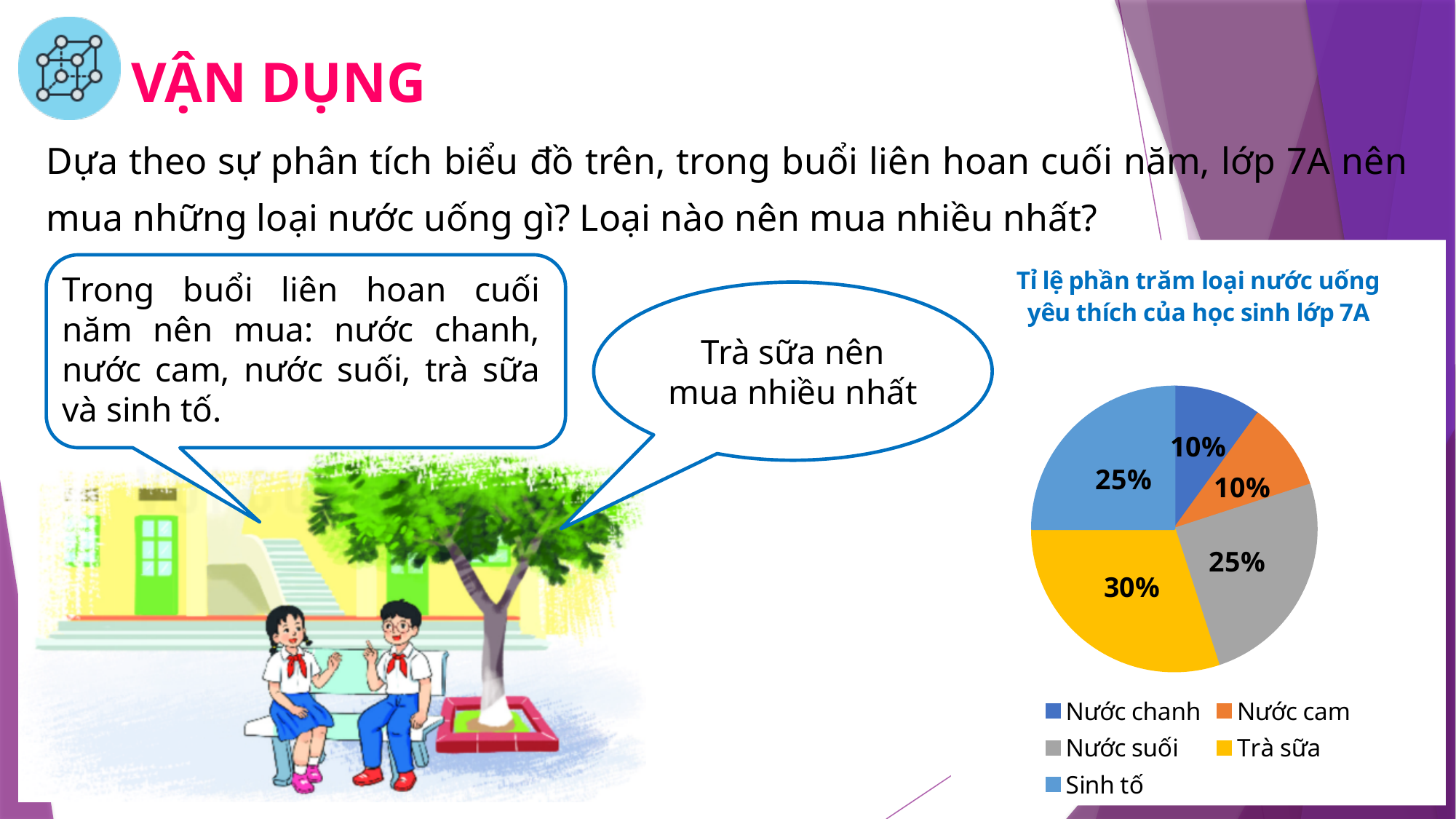
What percentage of the pie chart is Nước suối? 25% Which drink has the largest share of the pie chart? Trà sữa What is the combined share of Nước chanh and Nước cam in the pie chart? 20% What is the difference between the shares of Trà sữa and Nước chanh? 20% How many categories does the pie chart show? 5 What percentage of the pie chart is Trà sữa? 30% What percentage of the pie chart is Nước cam? 10% Which is larger in the pie chart, the share of Trà sữa or the share of Nước suối? Trà sữa What percentage of the pie chart is Sinh tố? 25% What is the title of the pie chart? Tỉ lệ phần trăm loại nước uống yêu thích của học sinh lớp 7A How many entries does the legend of the pie chart list? 5 What kind of chart is shown on the slide? pie chart